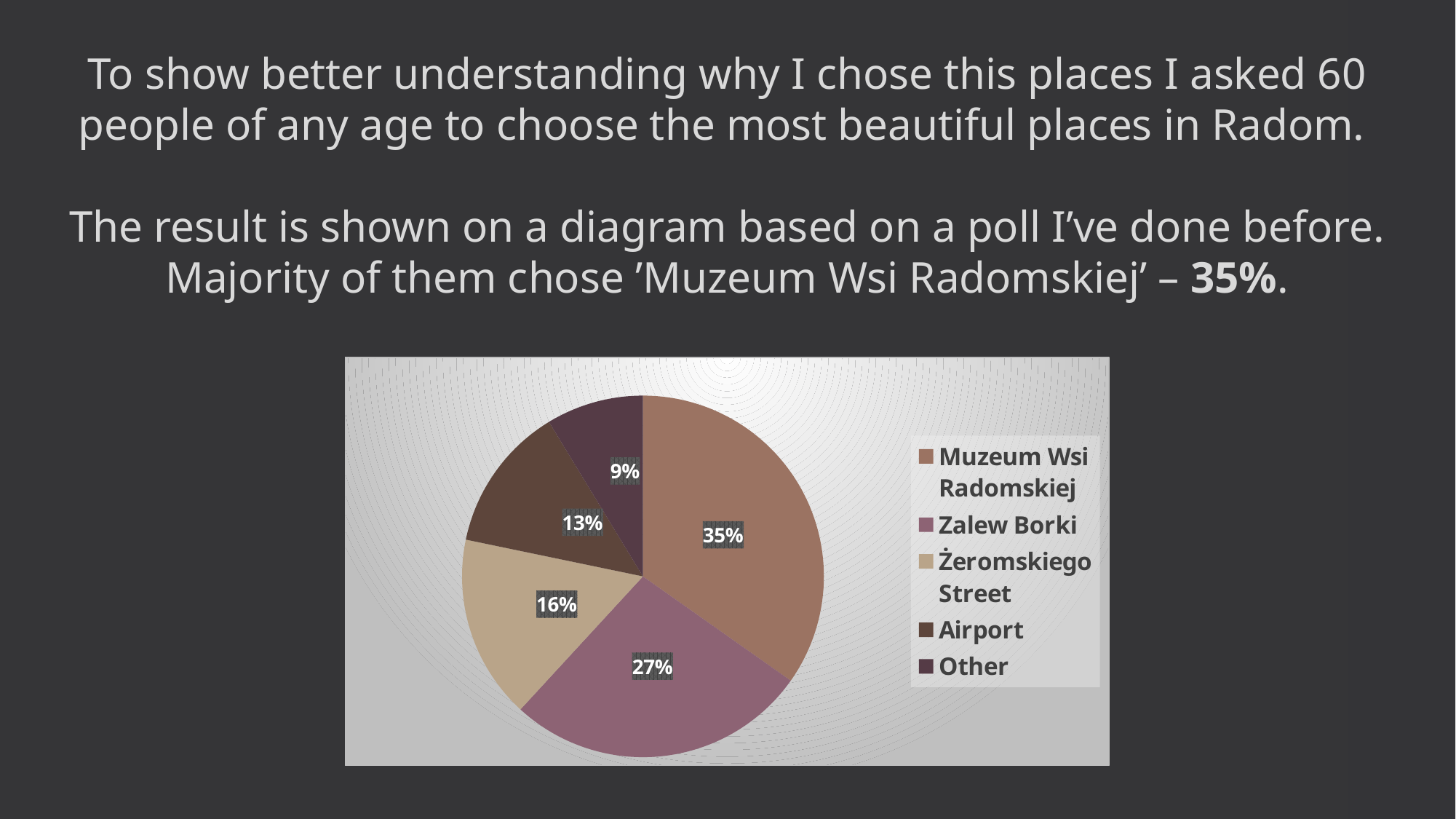
What share of the pie does Zalew Borki have? 27% Which category has the smallest slice of the pie? Other What is the difference in percentage points between Muzeum Wsi Radomskiej and Zalew Borki? 8 What share of the pie does Muzeum Wsi Radomskiej have? 35% What share of the pie does Other have? 9% What kind of chart is shown on the slide? pie chart How many categories does the pie chart have? 5 Which is larger, the share for Żeromskiego Street or the share for Airport? Żeromskiego Street Which category has the largest slice of the pie? Muzeum Wsi Radomskiej